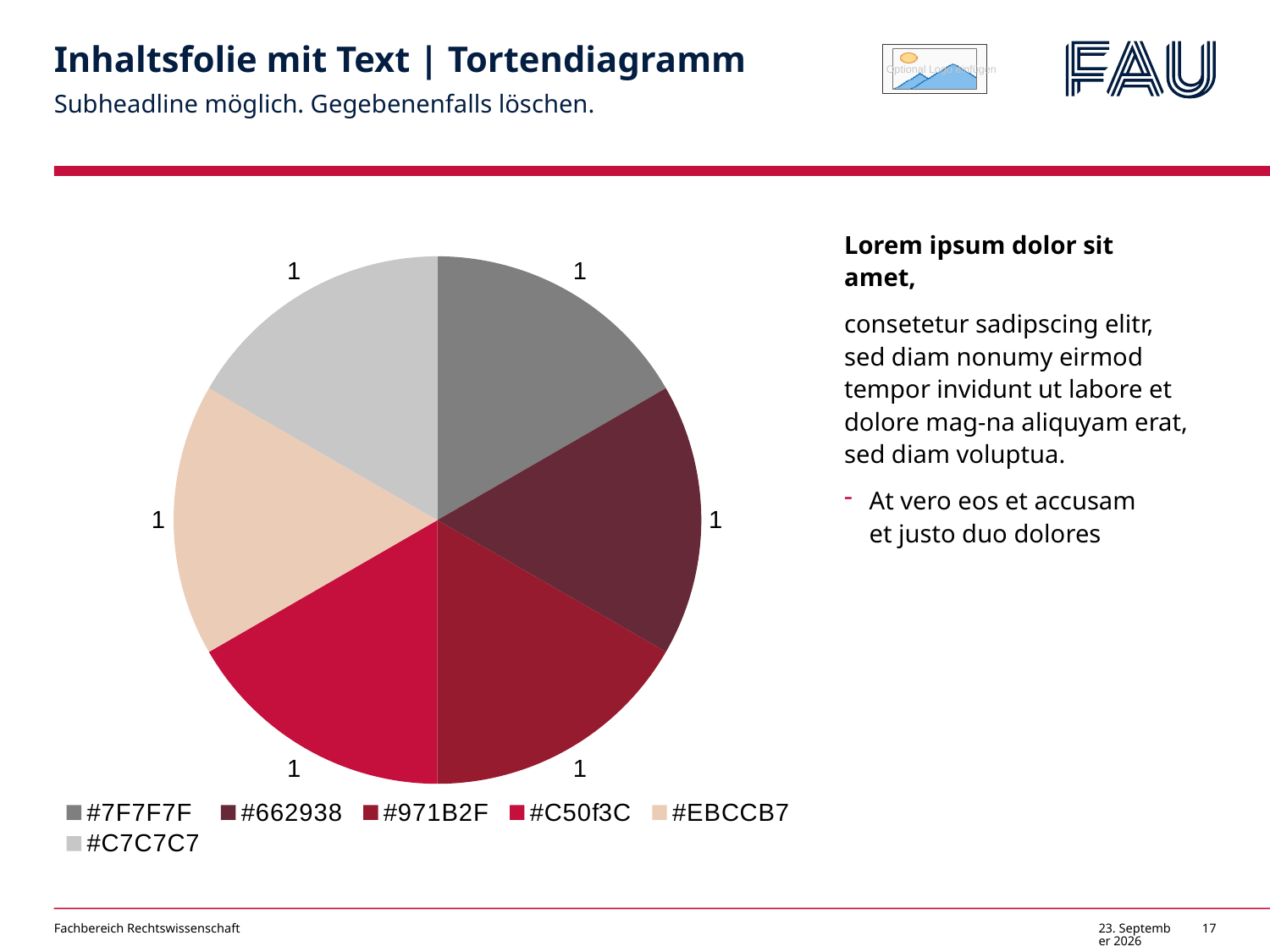
What is the value shown for the #EBCCB7 slice? 1 How many slices does the pie chart have? 6 What is the first entry listed in the legend of the pie chart? #7F7F7F What is the value shown for the #C7C7C7 slice? 1 What is the value shown for the #7F7F7F slice? 1 What is the value shown for the #C50f3C slice? 1 Do all slices of the pie chart have the same value? yes How many entries does the legend of the pie chart list? 6 What kind of chart is shown on the slide? pie chart What is the last entry listed in the legend of the pie chart? #C7C7C7 What is the total of all the slice values in the pie chart? 6